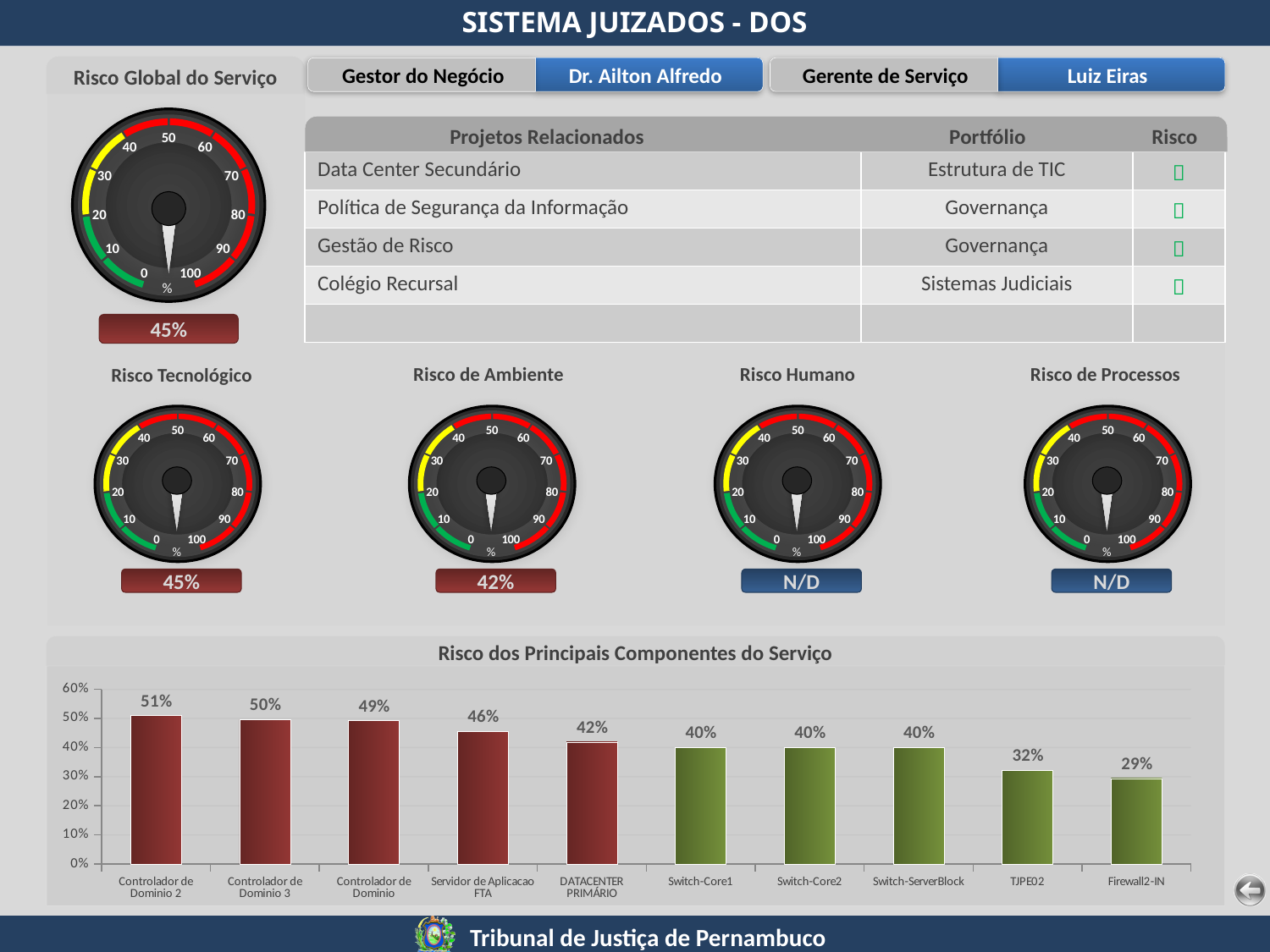
In the 'Risco dos Principais Componentes do Serviço' chart, which component has the highest value? Controlador de Dominio 2 What kind of chart is 'Risco dos Principais Componentes do Serviço'? Bar chart How many components are shown in the 'Risco dos Principais Componentes do Serviço' chart? 10 What value does the 'Risco de Ambiente' gauge show? 42% What value does the 'Risco Global do Serviço' gauge show? 45% In the 'Risco dos Principais Componentes do Serviço' chart, what is the value for Servidor de Aplicacao FTA? 46% In the 'Risco dos Principais Componentes do Serviço' chart, what is the value for TJPE02? 32% What value is shown for the 'Risco Humano' gauge? N/D In the 'Risco dos Principais Componentes do Serviço' chart, what is the difference between Controlador de Dominio 2 and Firewall2-IN? 22 percentage points In the 'Risco dos Principais Componentes do Serviço' chart, which component has the lowest value? Firewall2-IN In the 'Risco dos Principais Componentes do Serviço' chart, do the values rise or fall from left to right? Fall In the 'Risco dos Principais Componentes do Serviço' chart, which is larger: DATACENTER PRIMÁRIO or Switch-Core1? DATACENTER PRIMÁRIO